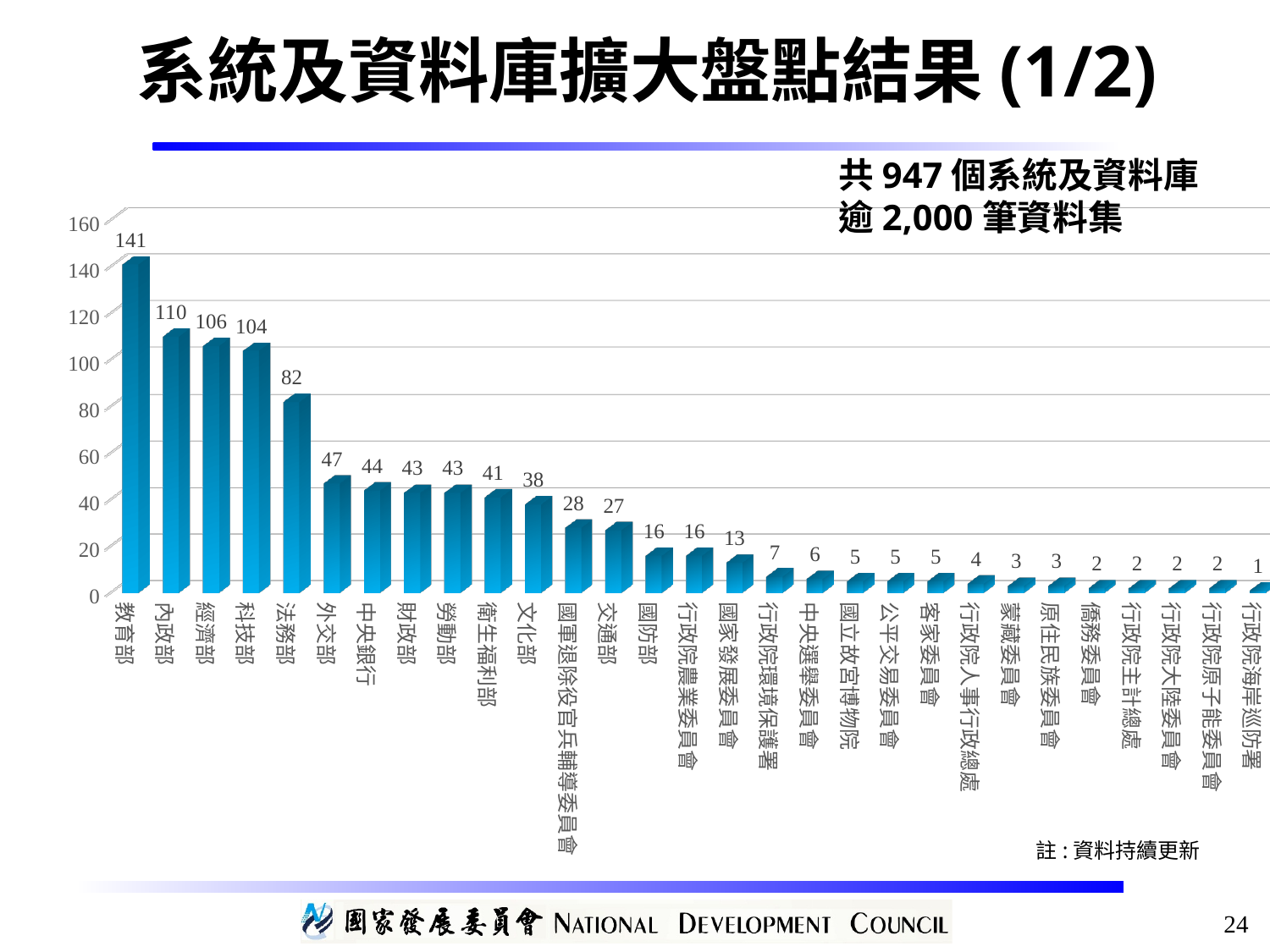
Is the value for 經濟部 greater or less than 100? greater What kind of chart is shown on the slide? bar chart Which category has the lowest value? 行政院海岸巡防署 Which is larger, the value for 外交部 or the value for 文化部? 外交部 What is the value for 國家發展委員會? 13 What is the value for 教育部? 141 Which category has the highest value? 教育部 How many categories are shown on the x axis? 29 What is the difference between the values for 內政部 and 科技部? 6 What is the title of the slide? 系統及資料庫擴大盤點結果 (1/2) What is the value for 法務部? 82 Do the values rise or fall from left to right along the x axis? fall